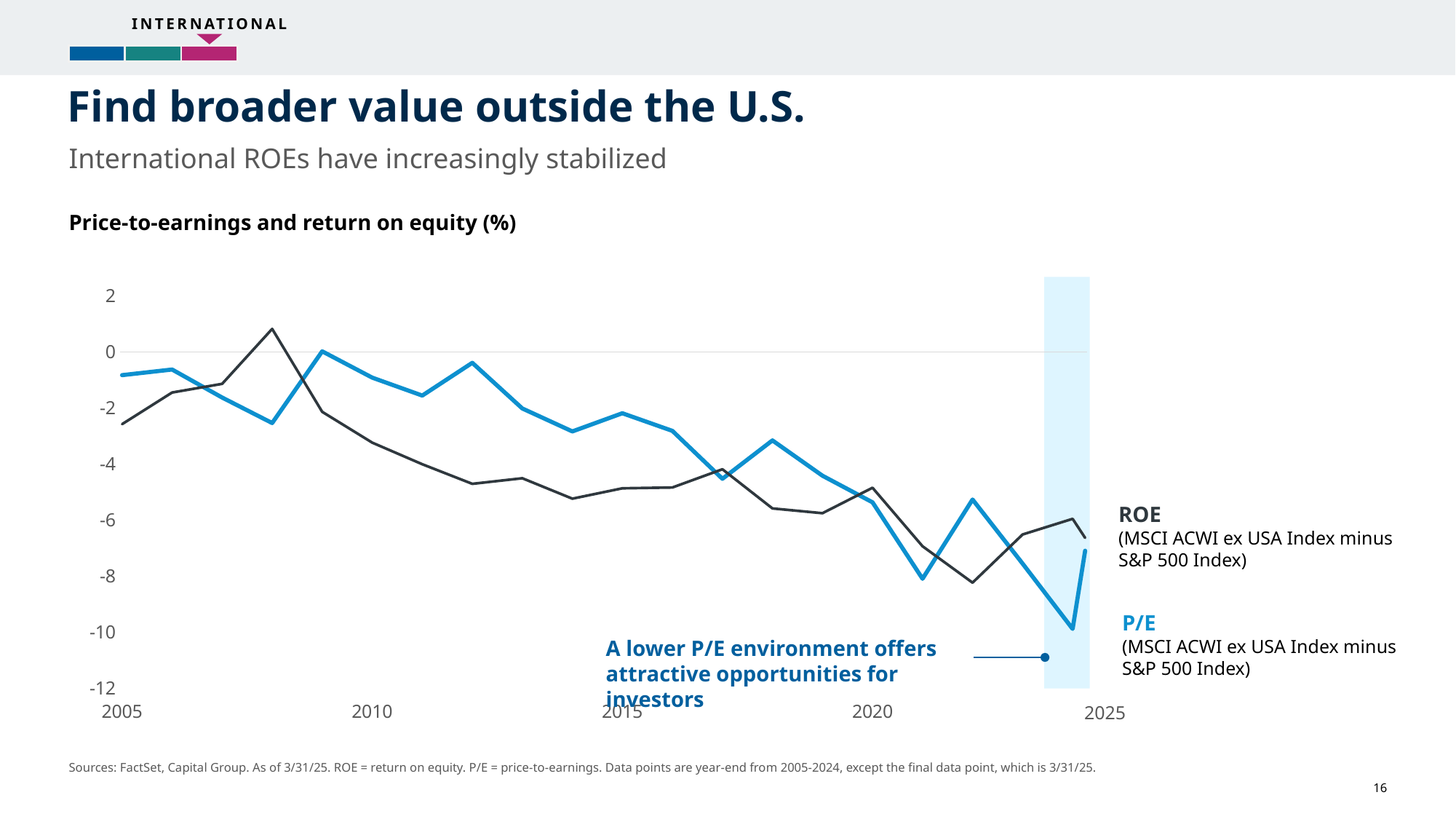
Is the P/E value in 2005 greater or less than -2? greater Is the ROE value in 2005 greater or less than -2? less What is the title of the chart? Price-to-earnings and return on equity (%) At the final data point (2025), which series has the higher value, ROE or P/E? ROE Is the ROE value at its peak around 2008 greater or less than 0? greater Overall, do the P/E values rise or fall from 2005 to 2024? fall In 2005, which series has the higher value, ROE or P/E? P/E Which colour is used for the P/E line? blue What kind of chart is shown on the slide? line chart Which series reaches the highest value anywhere on the chart? ROE How many series does the chart plot? 2